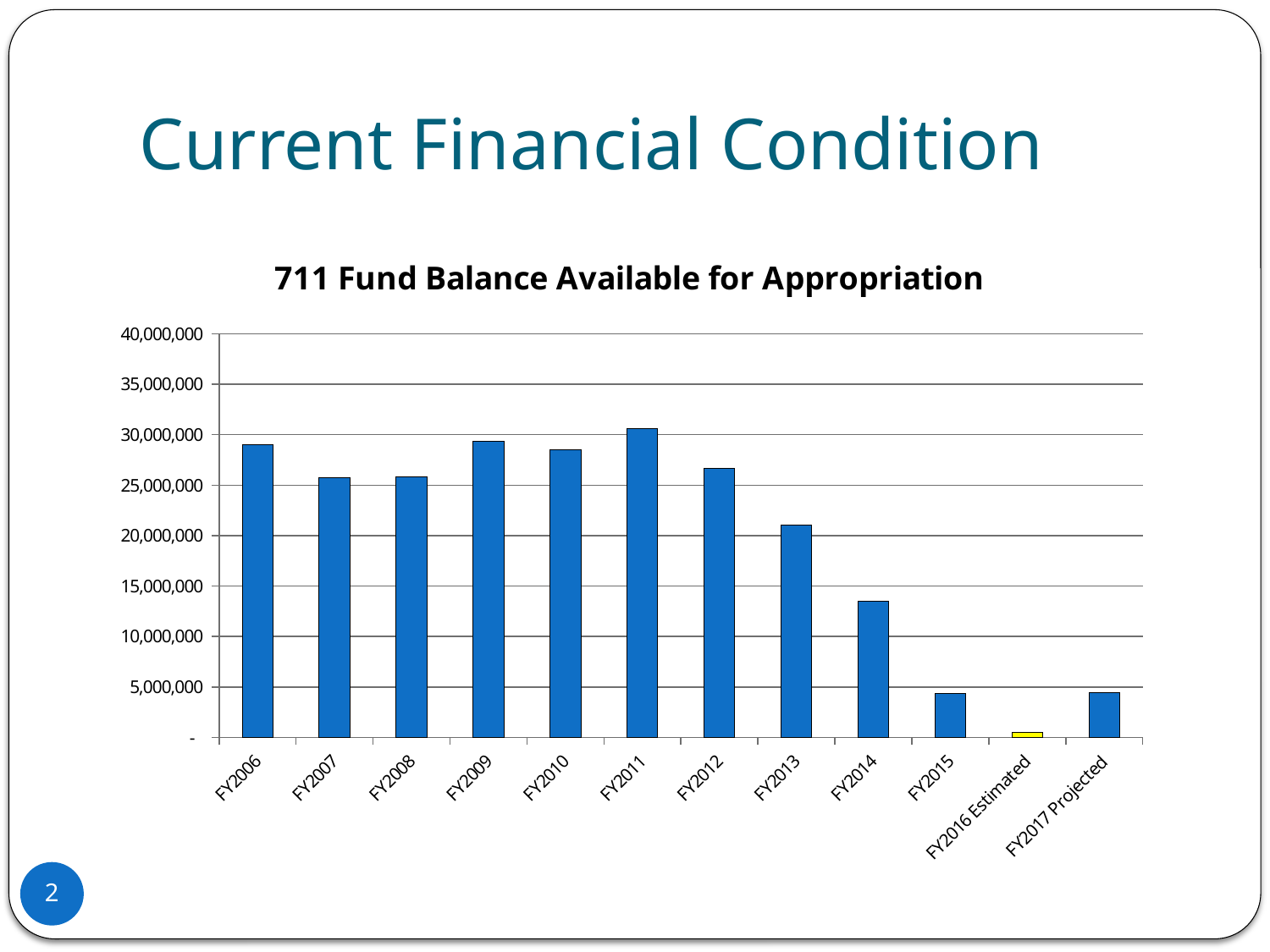
Do the values rise or fall from FY2011 to FY2016 Estimated? fall Is the value for FY2014 greater or less than 15,000,000? less Which is larger, the fund balance for FY2013 or for FY2014? FY2013 What kind of chart is shown on the slide? bar chart How many fiscal-year categories are plotted on the x axis? 12 Is the value for FY2011 greater or less than 30,000,000? greater Which category's bar is coloured yellow instead of blue? FY2016 Estimated What is the title of the chart? 711 Fund Balance Available for Appropriation Is the value for FY2013 greater or less than 20,000,000? greater Which fiscal year has the highest fund balance? FY2011 Which category has the lowest fund balance? FY2016 Estimated